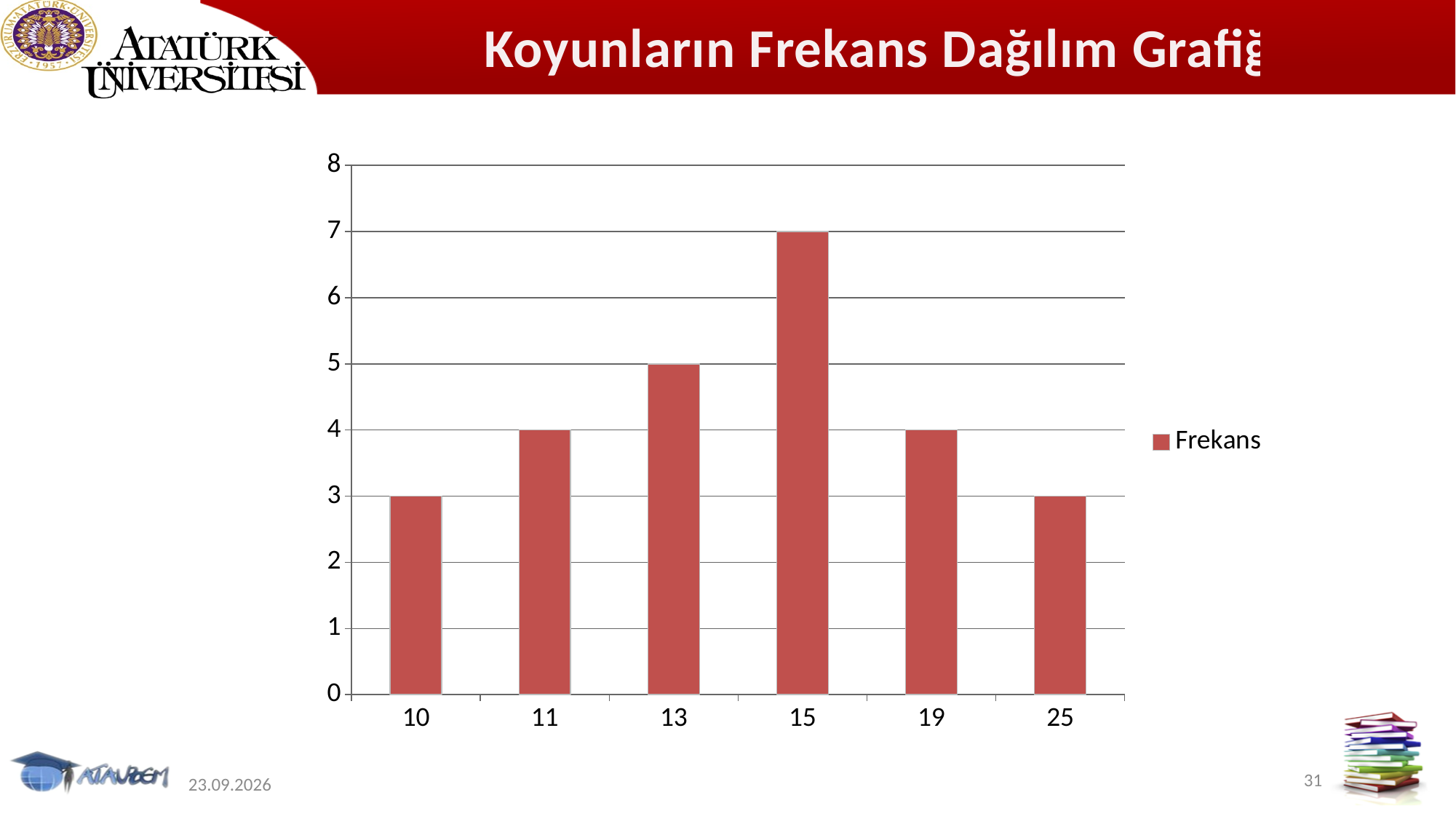
What is the Frekans value for category 10? 3 What is the difference between the Frekans values for categories 15 and 13? 2 How many categories are shown on the x axis of the chart? 6 Which has a larger Frekans value, category 11 or category 13? 13 Is the Frekans value for category 19 greater or less than 5? less Which category has the highest Frekans value? 15 What kind of chart is shown on the slide? bar chart What is the Frekans value for category 15? 7 What is the name of the series shown in the chart legend? Frekans What is the Frekans value for category 13? 5 Do the Frekans values rise or fall from category 15 to category 25? fall How many series does the chart legend list? 1